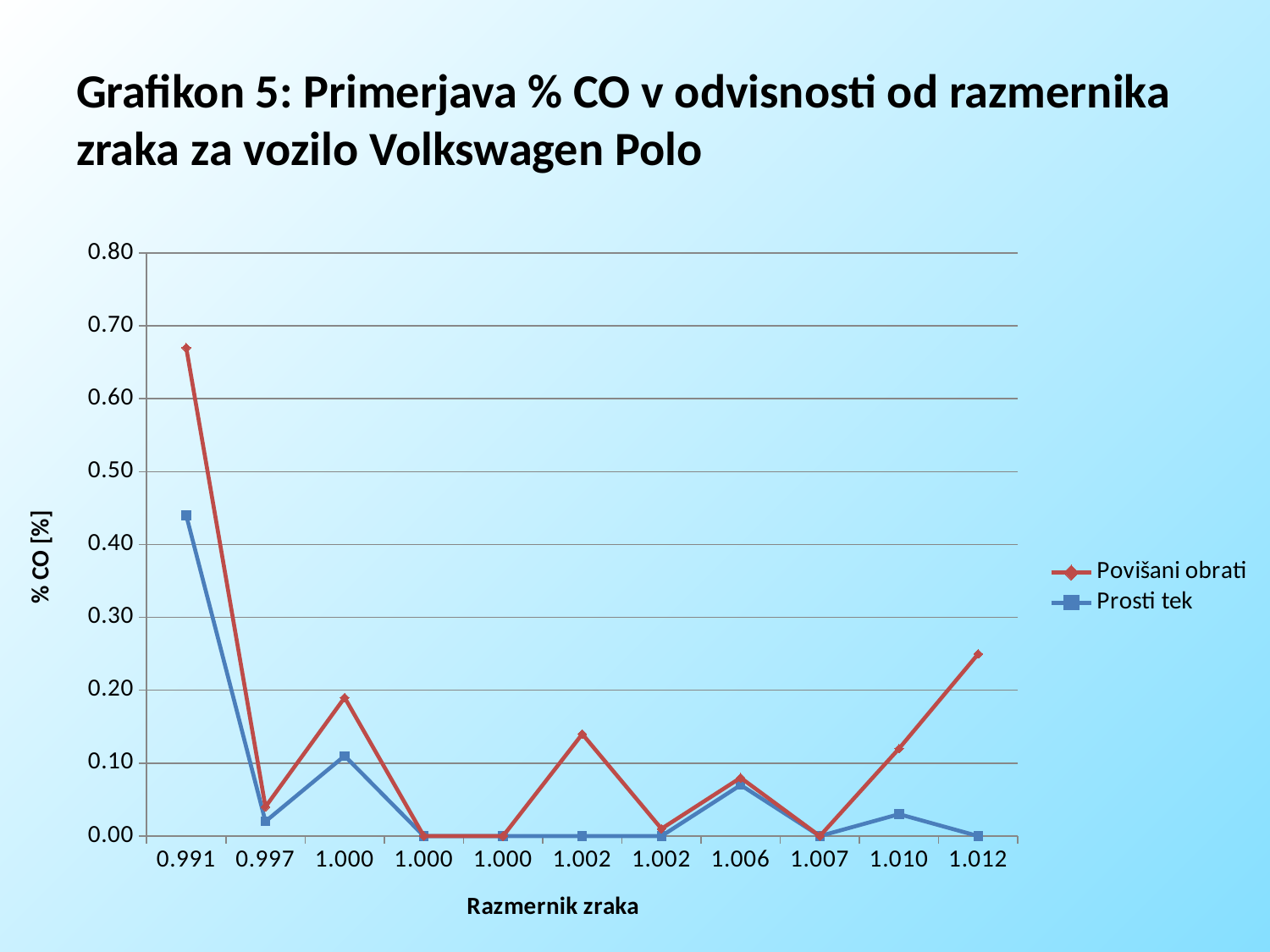
Is the Povišani obrati value at air ratio 1.012 greater or less than 0.20? greater At which air ratio does the Prosti tek series reach its highest % CO value? 0.991 What is the % CO value for Prosti tek at air ratio 1.012? 0.00 How many data points are plotted along the x axis for each series? 11 How many series does the legend list? 2 What is the % CO value for Povišani obrati at air ratio 1.007? 0.00 What kind of chart is shown on the slide? line chart At which air ratio (Razmernik zraka) does the Povišani obrati series reach its highest % CO value? 0.991 At air ratio 1.012, which series has the larger % CO value, Povišani obrati or Prosti tek? Povišani obrati Is the Prosti tek value at air ratio 0.991 greater or less than 0.40? greater What is the label of the y axis? % CO [%] Is the Povišani obrati value at air ratio 0.991 greater or less than 0.60? greater